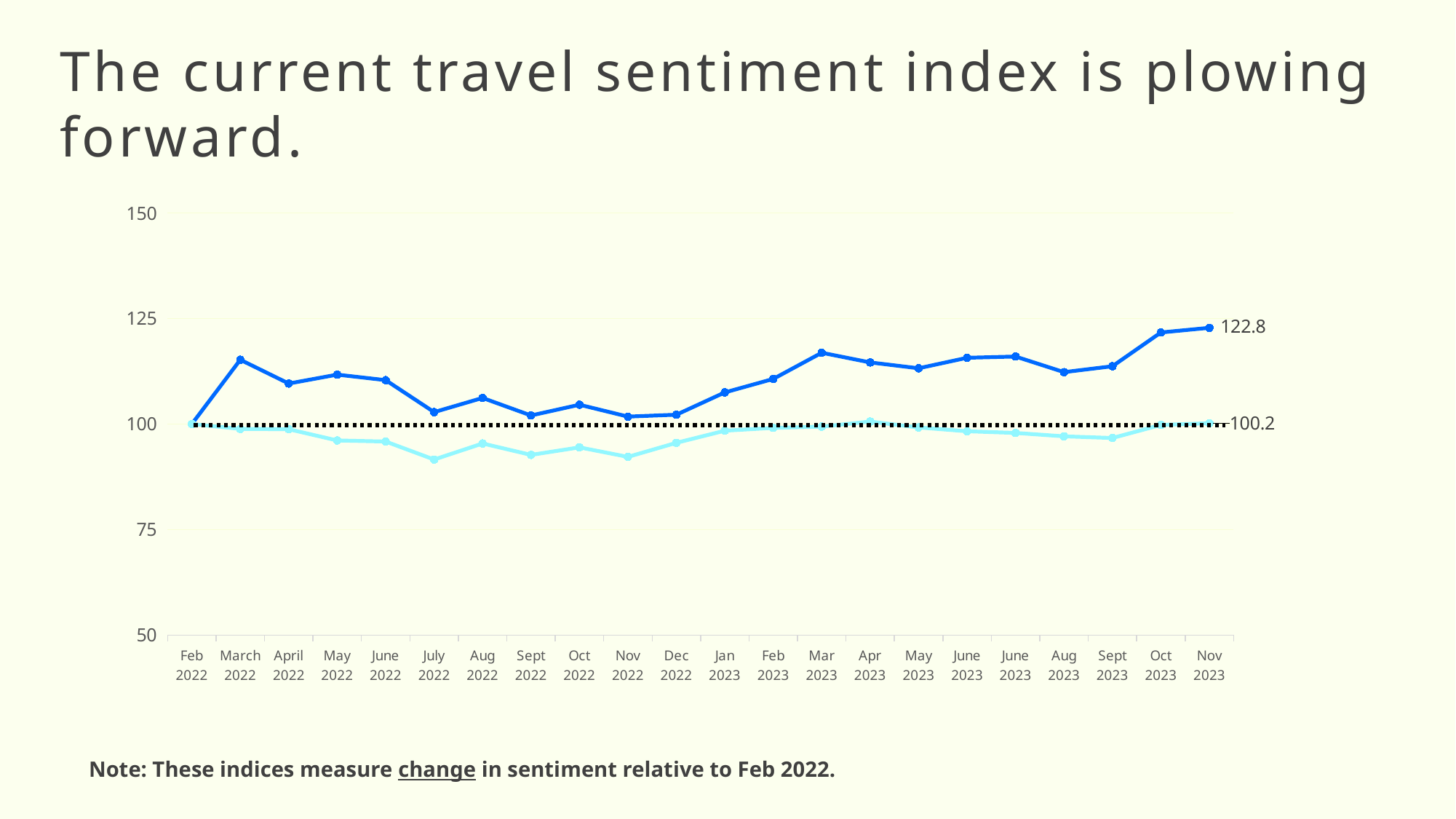
What is the value of the dark blue line at Nov 2023? 122.8 What kind of chart is shown on the slide? line chart How many months are shown along the x axis? 22 Is the value of the light blue line at July 2022 greater or less than 100? less What is the difference between the dark blue line and the light blue line at Nov 2023? 22.6 What is the value of the light blue line at Nov 2023? 100.2 What is the title of the slide? The current travel sentiment index is plowing forward. Is the value of the dark blue line at March 2022 greater or less than 100? greater Which line has the higher value at Nov 2023, the dark blue line or the light blue line? dark blue line At which month is the dark blue line at its lowest? Feb 2022 How many lines are plotted on the chart? 2 Does the dark blue line overall rise or fall from Feb 2022 to Nov 2023? rise